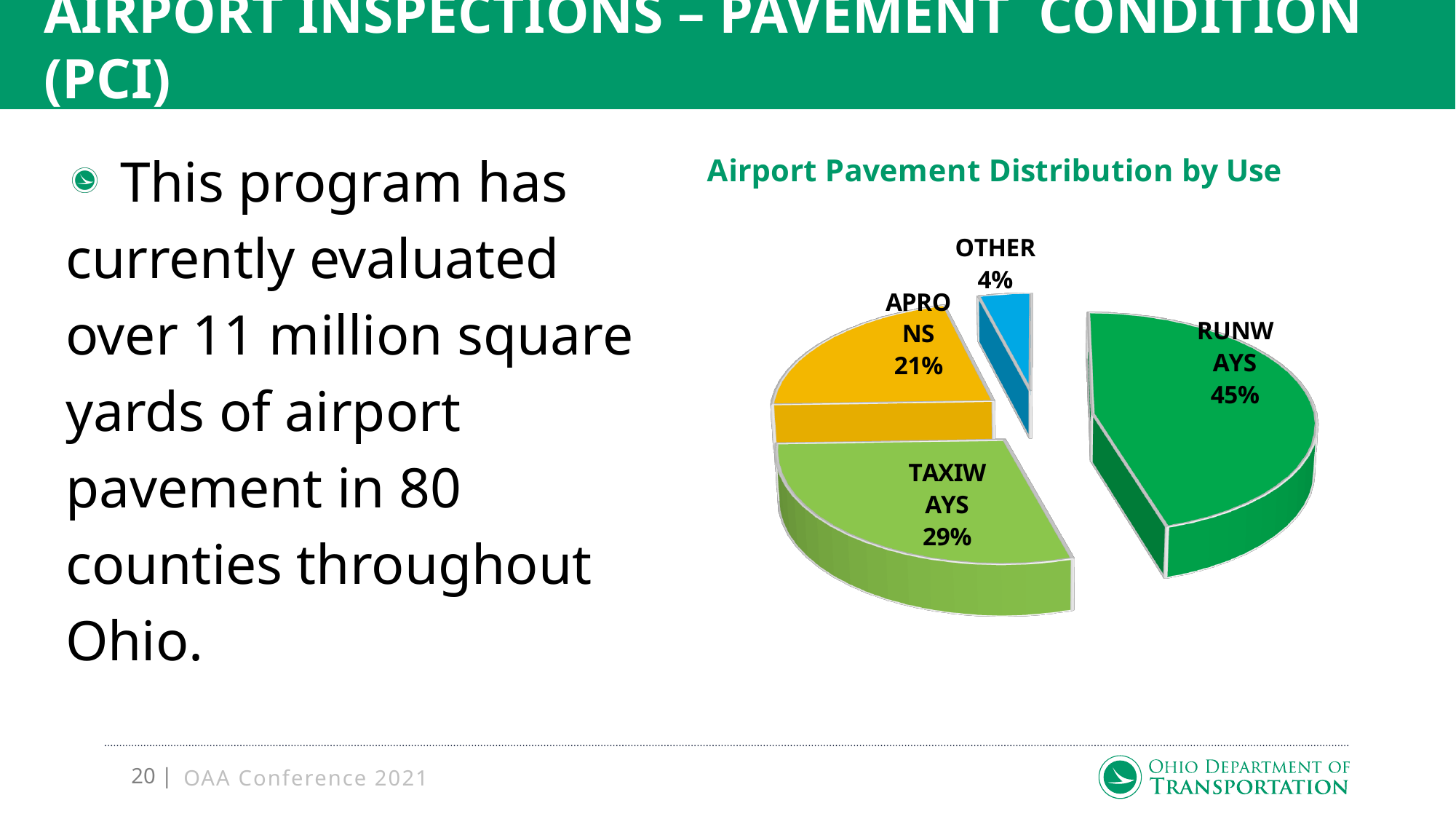
Which pavement use has the largest share of the pie? Runways What kind of chart is shown on the slide? Pie chart What share of airport pavement is taxiways? 29% What share of airport pavement is labelled Other? 4% Which pavement use has the smallest share of the pie? Other What is the title of the chart? Airport Pavement Distribution by Use What share of airport pavement is aprons? 21% How many slices does the pie chart have? 4 What share of airport pavement is runways? 45% Which is larger, the share for taxiways or the share for aprons? Taxiways How many percentage points larger is the aprons share than the Other share? 17 How many percentage points larger is the runways share than the taxiways share? 16